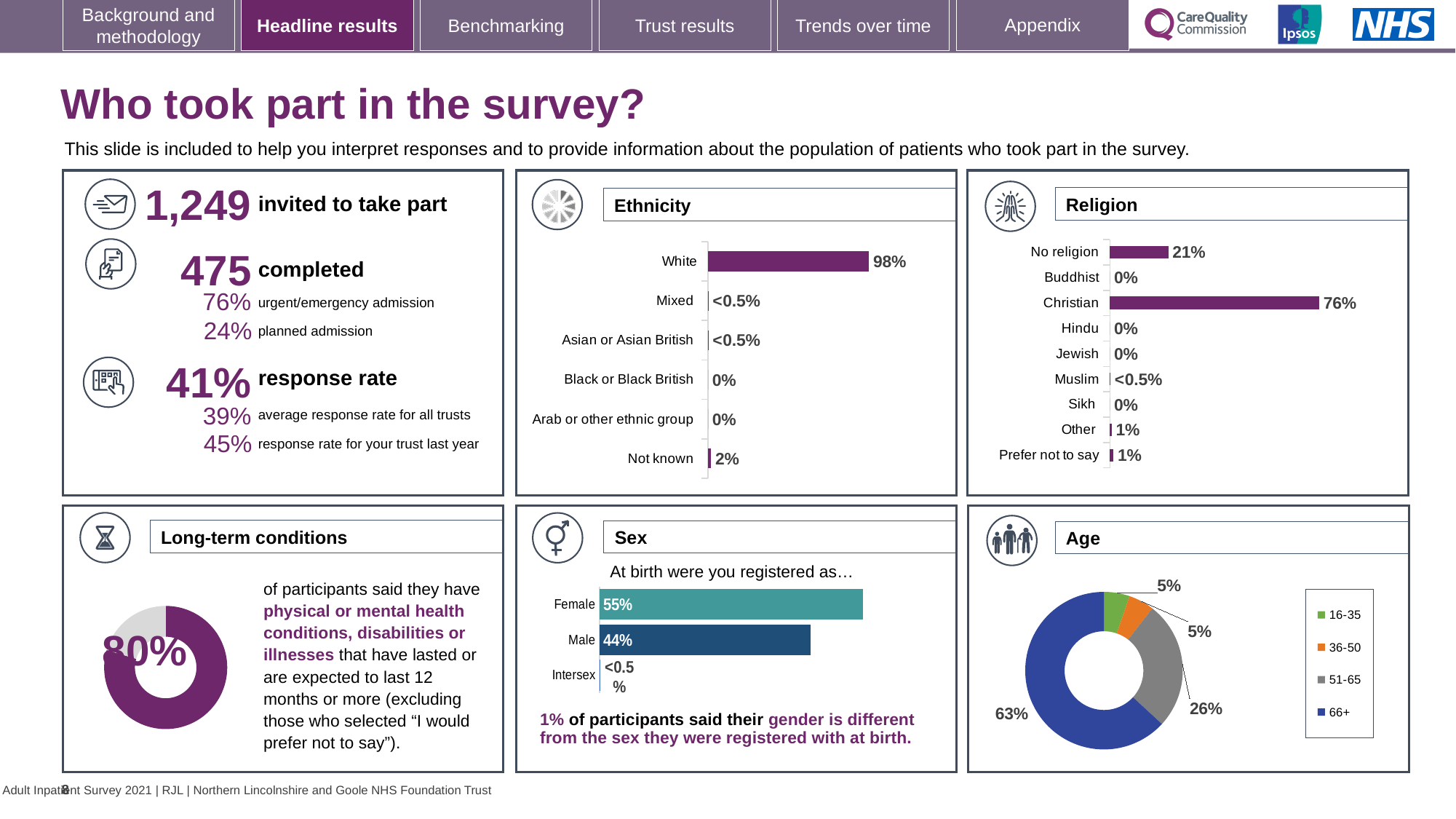
In the Sex chart, which is larger, Female or Male? Female In the Ethnicity chart, what is the value for Not known? 2% How many ethnicity categories are shown in the Ethnicity chart? 6 In the Age chart, what share of participants were aged 66+? 63% In the Ethnicity chart, what percentage of participants were White? 98% In the Religion chart, which religion category has the highest value? Christian In the Religion chart, what is the difference between the Christian and No religion values? 55% How many age groups does the legend of the Age chart list? 4 How many categories are listed in the Religion chart? 9 What kind of chart is the Age chart? Donut chart In the Sex chart, what percentage of participants were registered as Male at birth? 44% In the Religion chart, what is the value for No religion? 21%